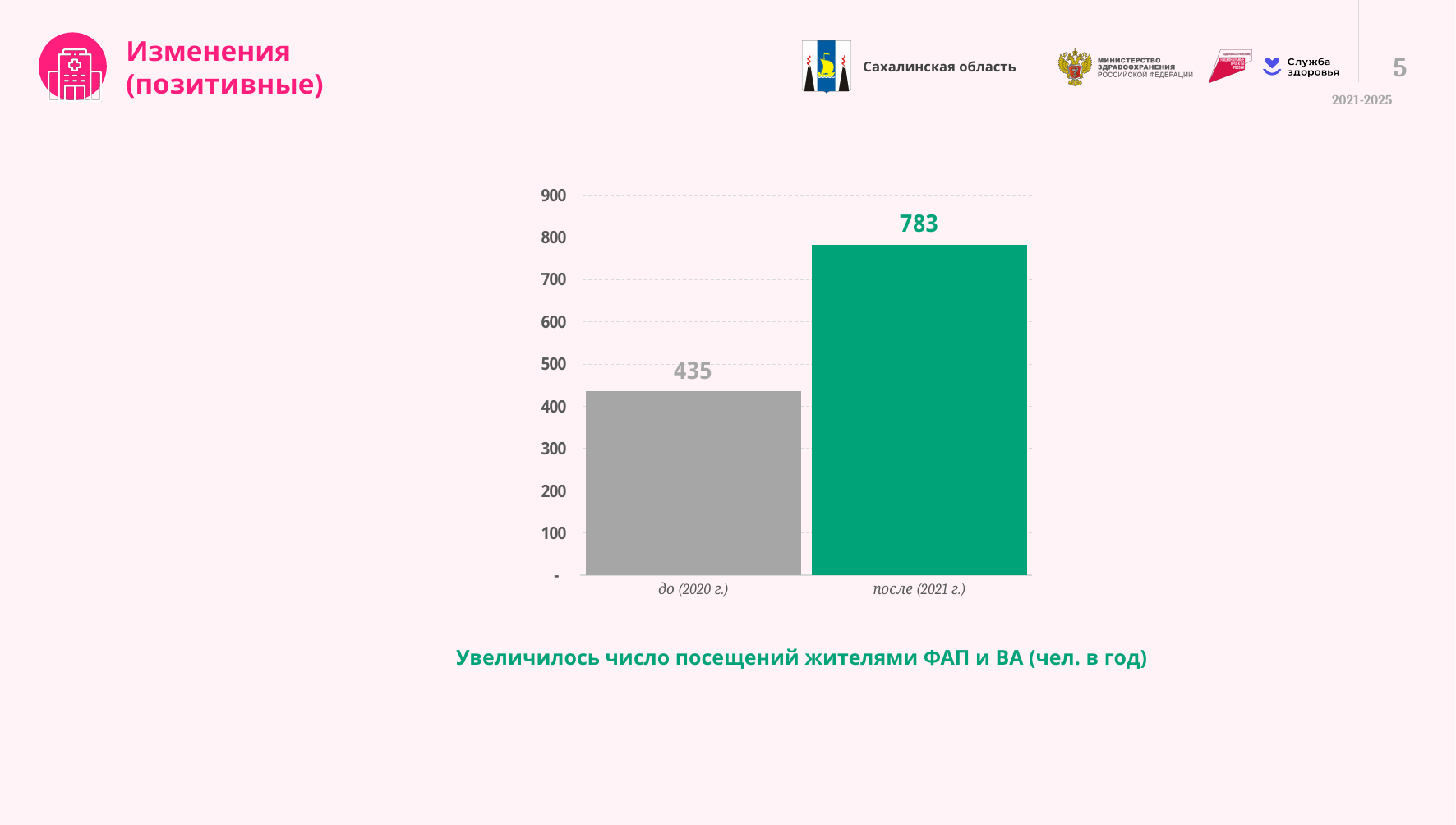
What is the difference between the values for "после (2021 г.)" and "до (2020 г.)"? 348 Which is larger, the value for "до (2020 г.)" or for "после (2021 г.)"? после (2021 г.) What is the value for "до (2020 г.)"? 435 What is the highest tick value shown on the vertical axis? 900 Is the value for "после (2021 г.)" greater or less than 700? greater Do the values rise or fall from "до (2020 г.)" to "после (2021 г.)"? rise Which category has the lowest value? до (2020 г.) What is the value for "после (2021 г.)"? 783 What kind of chart is shown on the slide? bar chart How many categories are shown on the chart? 2 Which category has the highest value? после (2021 г.) Is the value for "до (2020 г.)" greater or less than 500? less